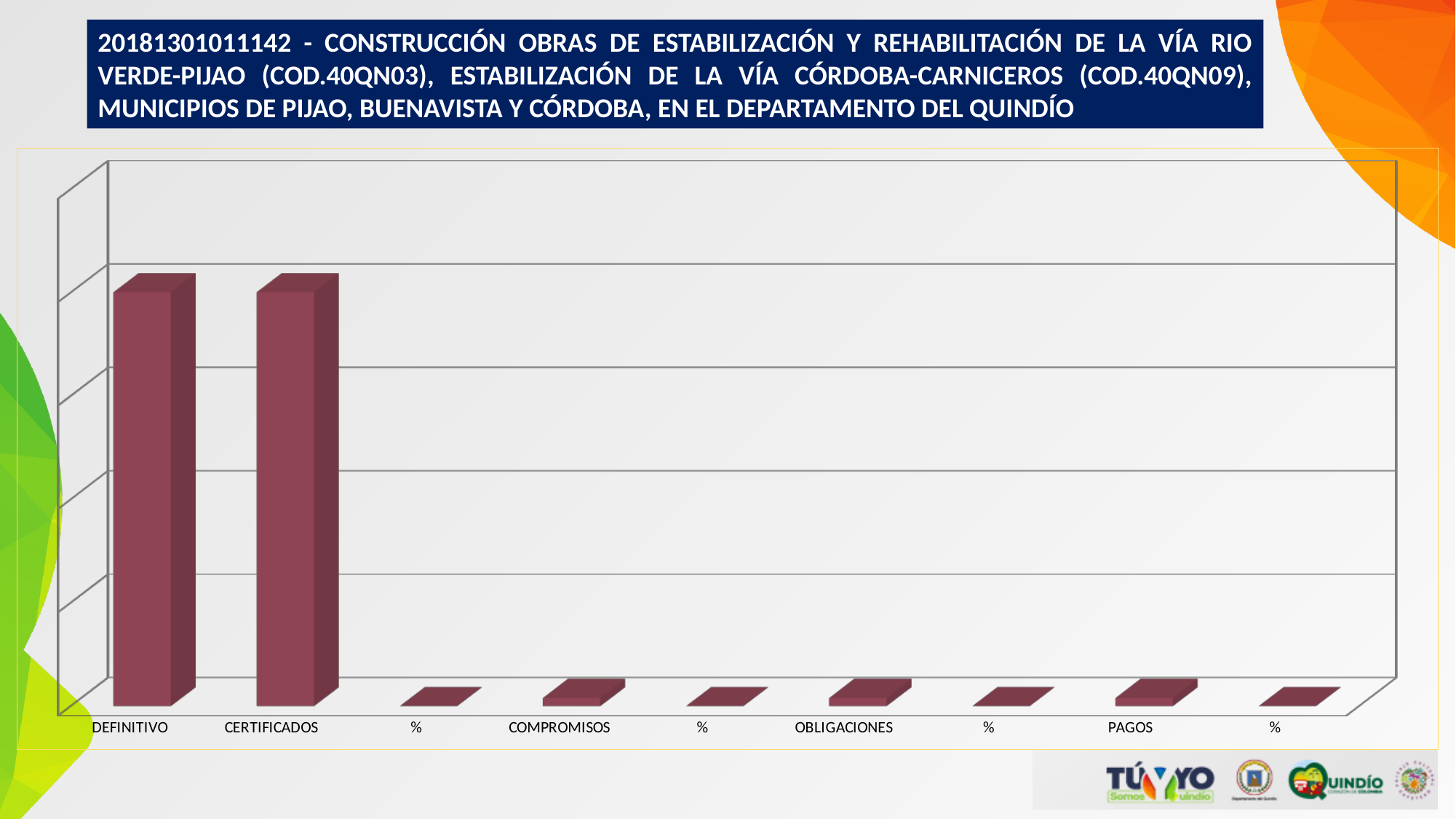
What is the label of the first category on the x axis? DEFINITIVO What kind of chart is shown on the slide? bar chart Which is larger, the value for PAGOS or the value for DEFINITIVO? DEFINITIVO Which is larger, the value for CERTIFICADOS or the value for PAGOS? CERTIFICADOS Which is larger, the value for CERTIFICADOS or the value for OBLIGACIONES? CERTIFICADOS What colour are the bars in the chart? dark red How many categories are shown along the x axis of the chart? 9